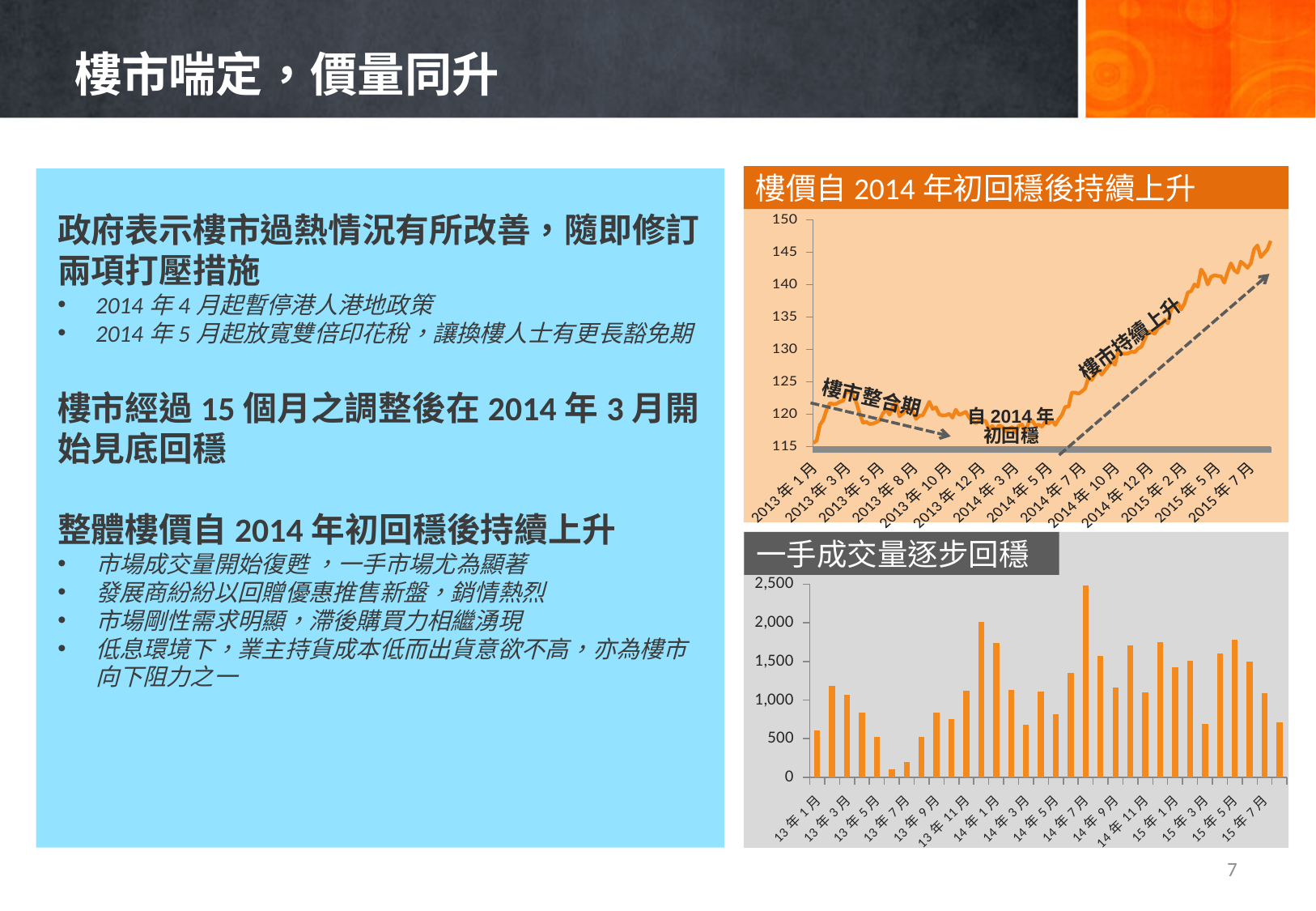
In the bottom-right bar chart, which month has the highest bar? 14年7月 In the bottom-right bar chart, which is larger, the value for 14年7月 or the value for 13年7月? 14年7月 In the bottom-right bar chart, is the value for 13年7月 greater or less than 500? less In the top-right line chart, is the value at 2013年1月 greater or less than 120? less In the top-right line chart, is the value at 2014年5月 greater or less than 125? less What kind of chart is the bottom-right chart titled 一手成交量逐步回穩? bar chart In the top-right line chart, do the values overall rise or fall from 2013年1月 to 2015年7月? rise What is the title of the top-right line chart? 樓價自 2014 年初回穩後持續上升 What kind of chart is the top-right chart titled 樓價自 2014 年初回穩後持續上升? line chart